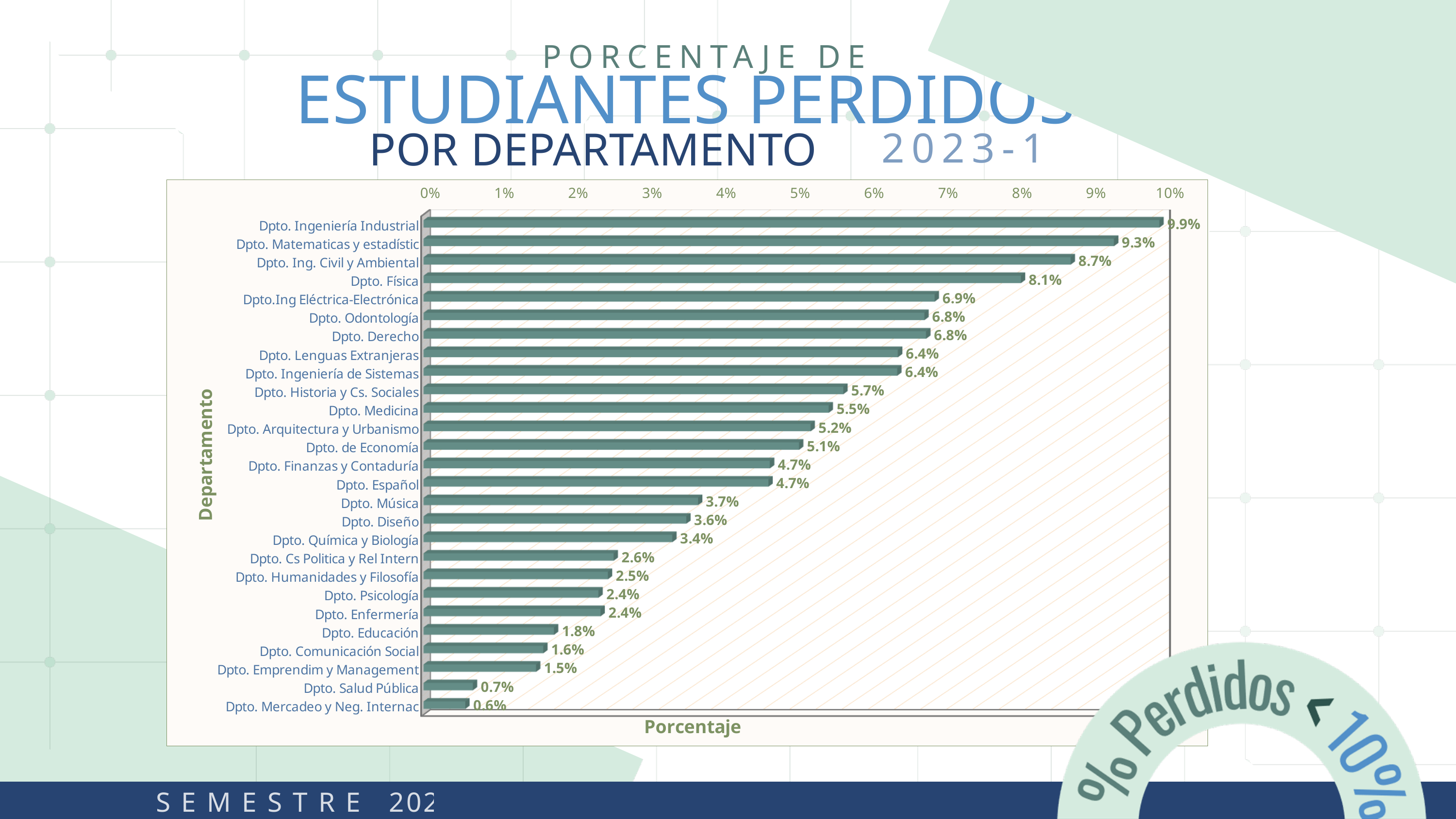
What is the value for Dpto. Física? 8.1% What is the value for Dpto. Salud Pública? 0.7% Which department has the highest percentage? Dpto. Ingeniería Industrial What is the value for Dpto. Medicina? 5.5% What is the label of the horizontal axis? Porcentaje What kind of chart is shown on the slide? bar chart Is the value for Dpto. Ing. Civil y Ambiental greater or less than 8%? greater Which is larger, the value for Dpto. Derecho or the value for Dpto. Música? Dpto. Derecho How many departments are shown in the chart? 27 What is the value for Dpto. Ingeniería Industrial? 9.9% What is the difference between Dpto. Ingeniería Industrial and Dpto. Matematicas y estadístic? 0.6% Which department has the lowest percentage? Dpto. Mercadeo y Neg. Internac